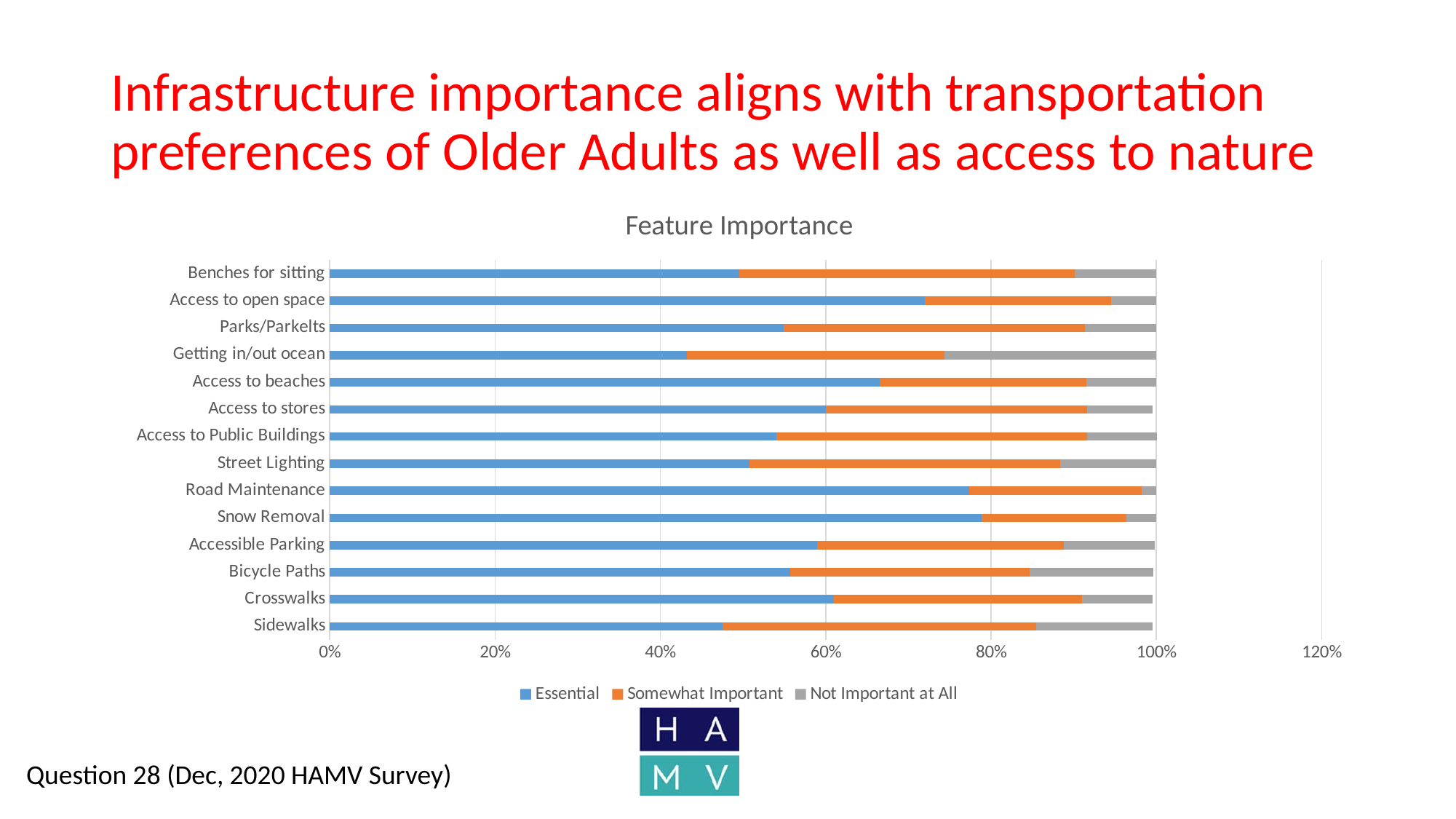
Which category has the largest Not Important at All share? Getting in/out ocean Is the Essential value for Sidewalks greater or less than 60%? less Which series is shown in orange in the legend? Somewhat Important What kind of chart is shown on the slide? Stacked bar chart Is the Essential value for Snow Removal greater or less than 60%? greater Which has a larger Essential share, Road Maintenance or Sidewalks? Road Maintenance What is the title of the chart? Feature Importance Which category has the lowest Essential share? Getting in/out ocean Is the Essential value for Getting in/out ocean greater or less than 60%? less How many feature categories are plotted on the chart? 14 How many series does the legend list? 3